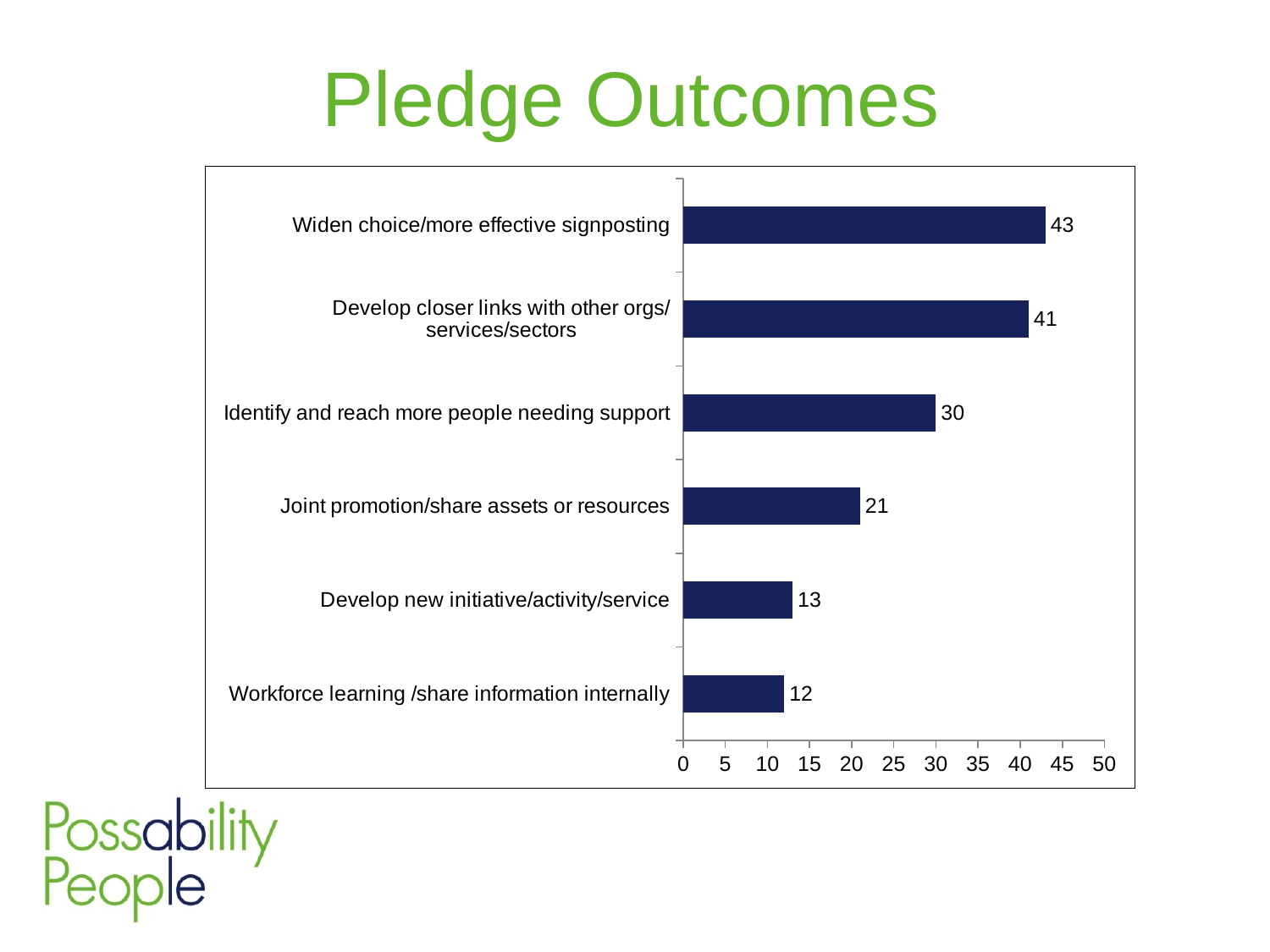
What is the title of the slide? Pledge Outcomes Is the value for Develop closer links with other orgs/services/sectors greater or less than 35? greater What is the difference between the values for Identify and reach more people needing support and Joint promotion/share assets or resources? 9 Which category has the highest value? Widen choice/more effective signposting How many categories are shown in the chart? 6 Which category has the lowest value? Workforce learning /share information internally What is the value for Widen choice/more effective signposting? 43 Which is larger: the value for Joint promotion/share assets or resources or the value for Develop new initiative/activity/service? Joint promotion/share assets or resources What is the value for Identify and reach more people needing support? 30 What is the value for Develop new initiative/activity/service? 13 What kind of chart is shown on the slide? Bar chart What is the difference between the values for Widen choice/more effective signposting and Develop closer links with other orgs/services/sectors? 2